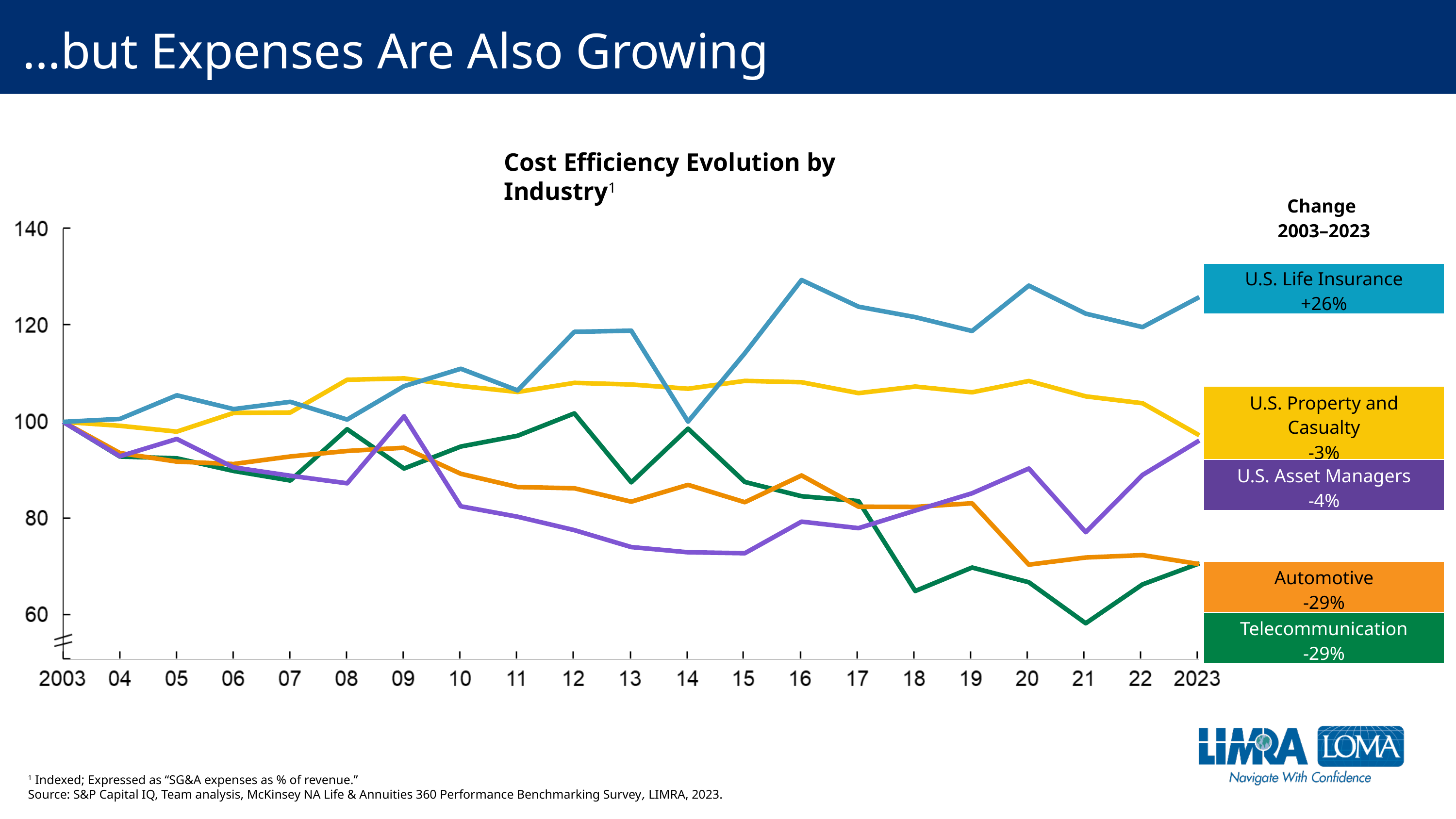
What is the title of the chart? Cost Efficiency Evolution by Industry How many industry series are plotted on the chart? 5 What is the 2003–2023 change shown for U.S. Property and Casualty? -3% Does the U.S. Life Insurance line rise or fall overall from 2003 to 2023? rise What kind of chart is shown on the slide? line chart Is the value for Telecommunication in 2021 greater or less than 60? less What is the 2003–2023 change shown for U.S. Life Insurance? +26% What is the 2003–2023 change shown for U.S. Asset Managers? -4% Is the value for U.S. Asset Managers in 2015 greater or less than 80? less Is the value for U.S. Life Insurance in 2016 greater or less than 120? greater Which industry has the highest 2003–2023 change? U.S. Life Insurance What is the 2003–2023 change shown for Automotive? -29%